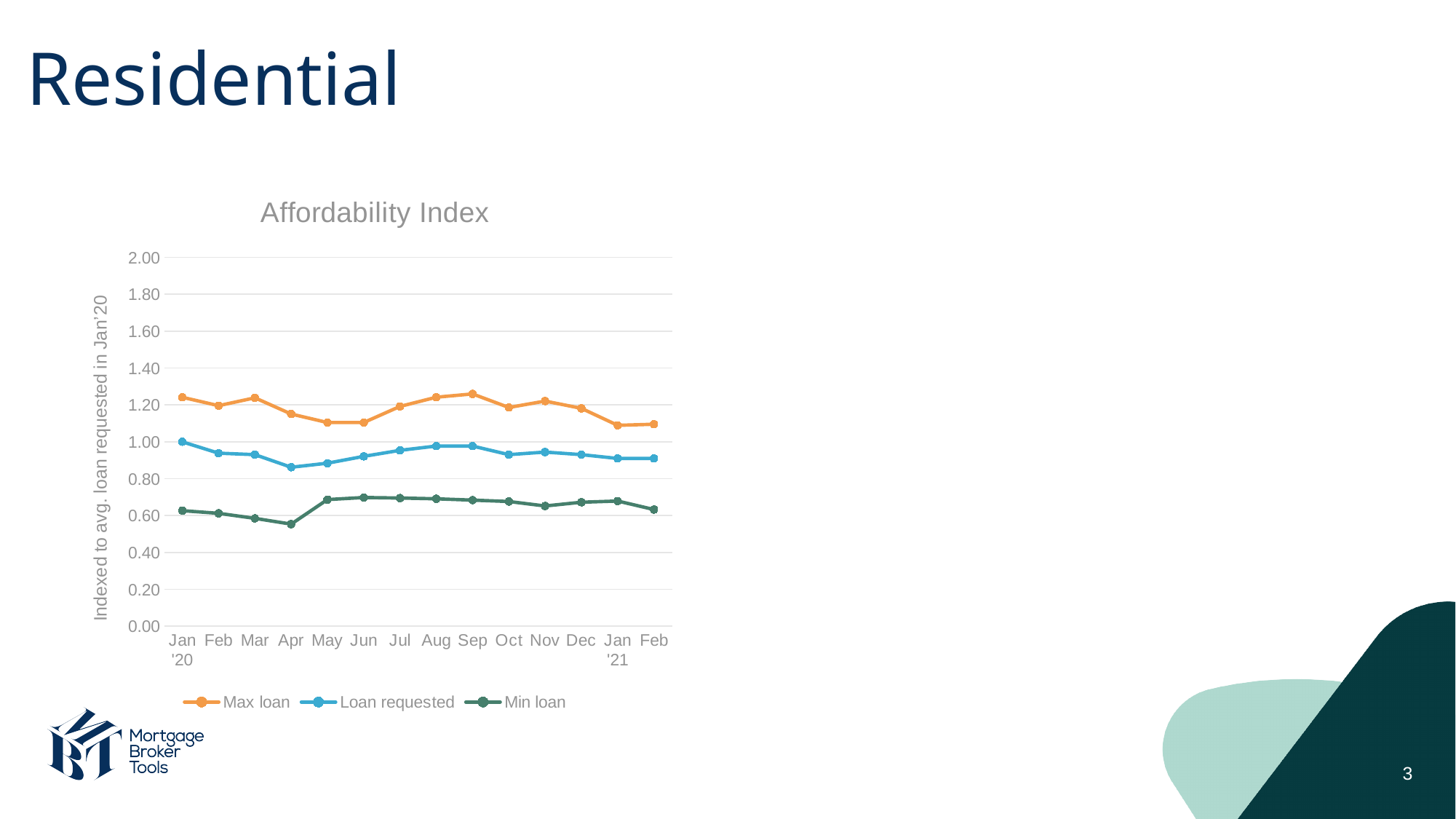
In which month is the Min loan series at its lowest? Apr Which series is higher in Jul: Max loan or Min loan? Max loan What is the title of the chart? Affordability Index Is the Max loan value for Jan '21 greater or less than 1.20? less How many series does the legend of the Affordability Index chart list? 3 What is the Loan requested value in Jan '20? 1.00 Is the Loan requested value for Apr greater or less than 0.90? less Is the Min loan value for Apr greater or less than 0.60? less Does the Min loan series rise or fall from Jan '20 to Apr? Fall What type of chart is shown on the slide? Line chart How many months are plotted along the x axis of the Affordability Index chart? 14